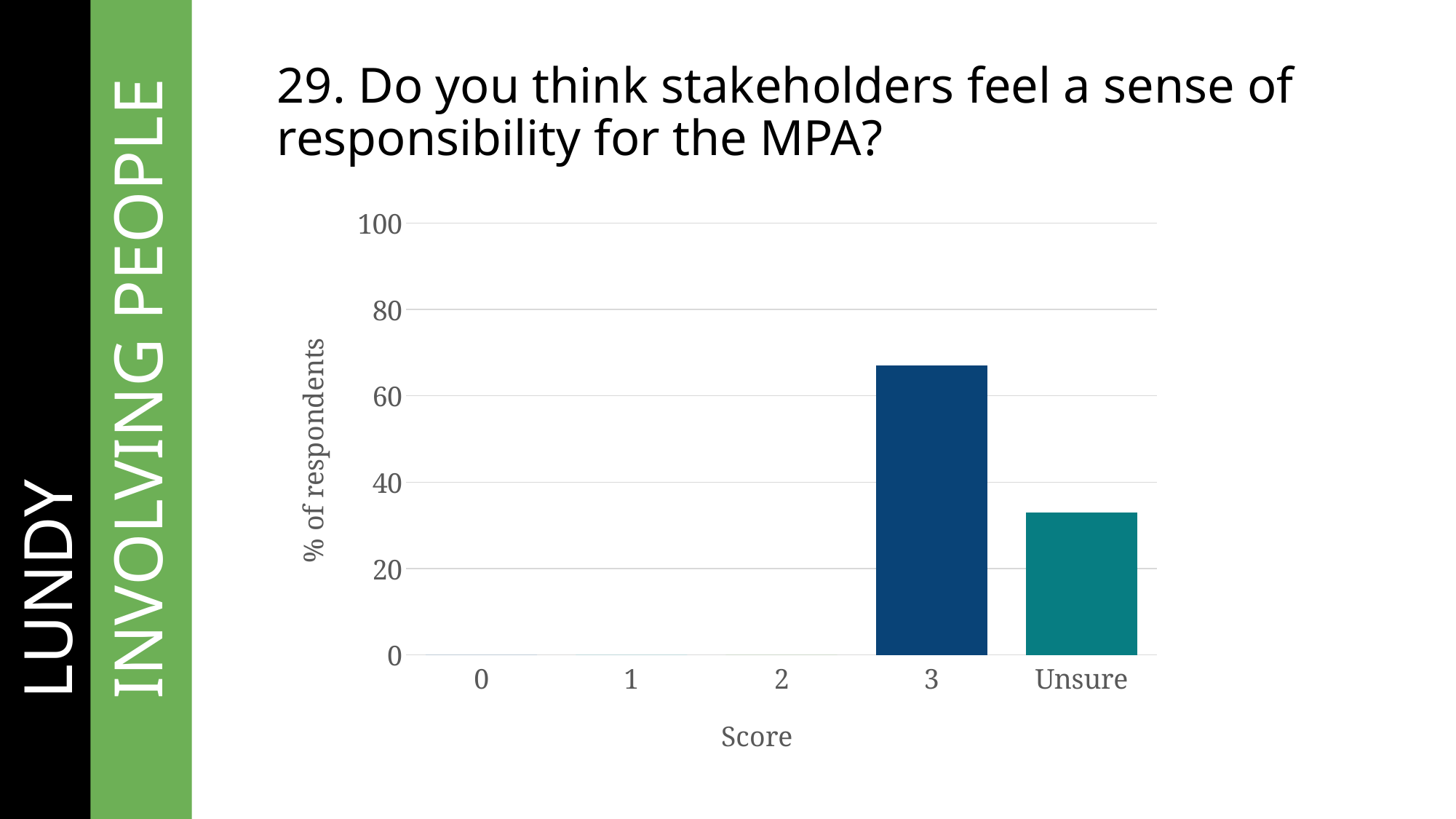
How many categories are shown on the x axis of the chart? 5 What is the label on the x axis of the chart? Score Is the value for Unsure greater or less than 20? greater What is the label on the y axis of the chart? % of respondents How many categories have a visible bar in the chart? 2 What kind of chart is shown on the slide? bar chart Which category has the highest percentage of respondents? 3 Is the value for Unsure greater or less than 40? less Which is larger, the value for score 3 or the value for Unsure? 3 Of the categories with a visible bar, which has the lower value? Unsure Is the value for score 3 greater or less than 80? less